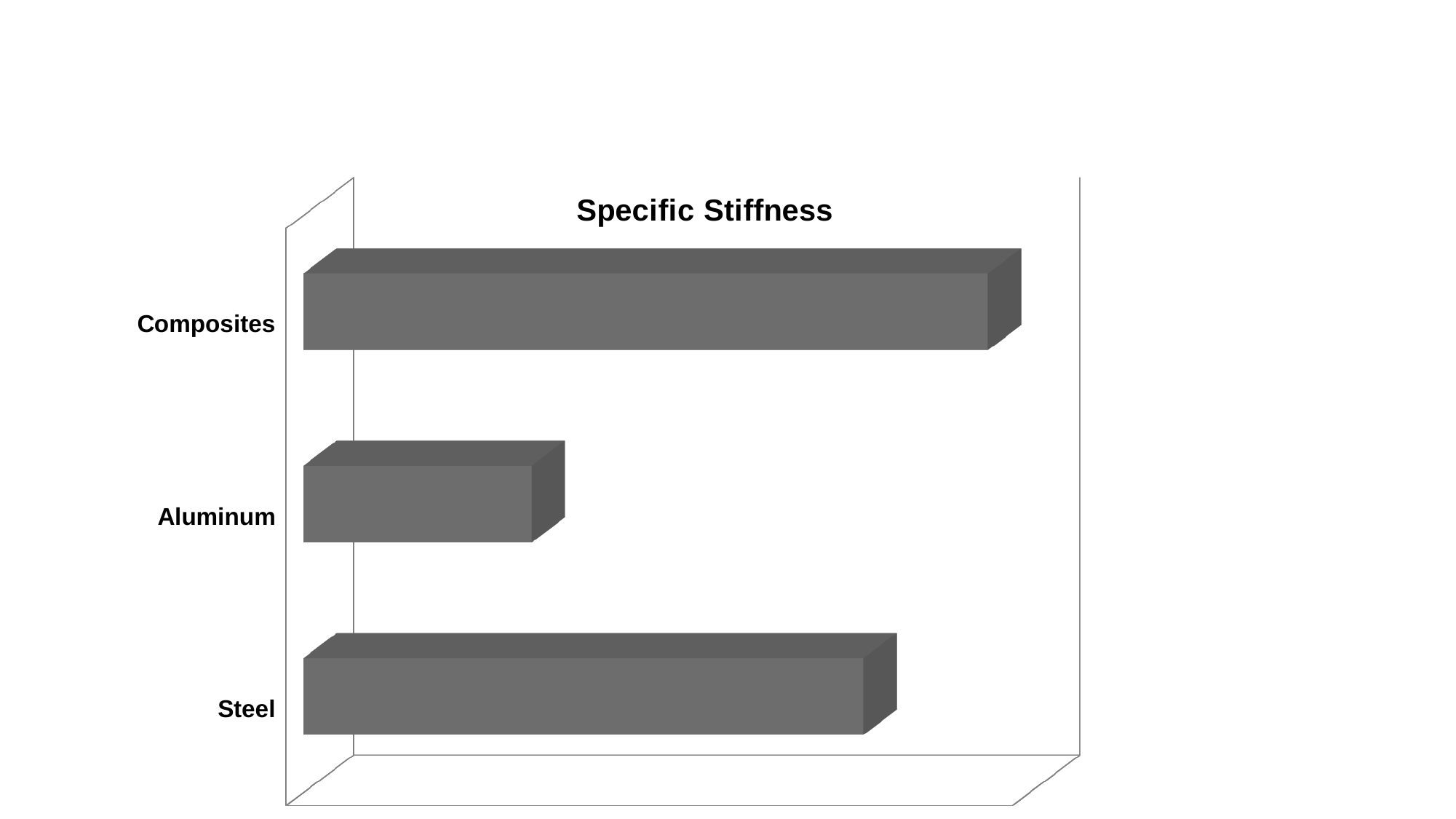
Which has the larger value, Composites or Steel? Composites Which has the larger value, Aluminum or Composites? Composites Which category has the highest specific stiffness? Composites Are the bars in the chart drawn horizontally or vertically? horizontally What is the title of the chart? Specific Stiffness Which category is listed at the top of the chart? Composites What kind of chart is shown on the slide? bar chart Which has the larger value, Steel or Aluminum? Steel Which category has the lowest specific stiffness? Aluminum How many categories are plotted in the chart? 3